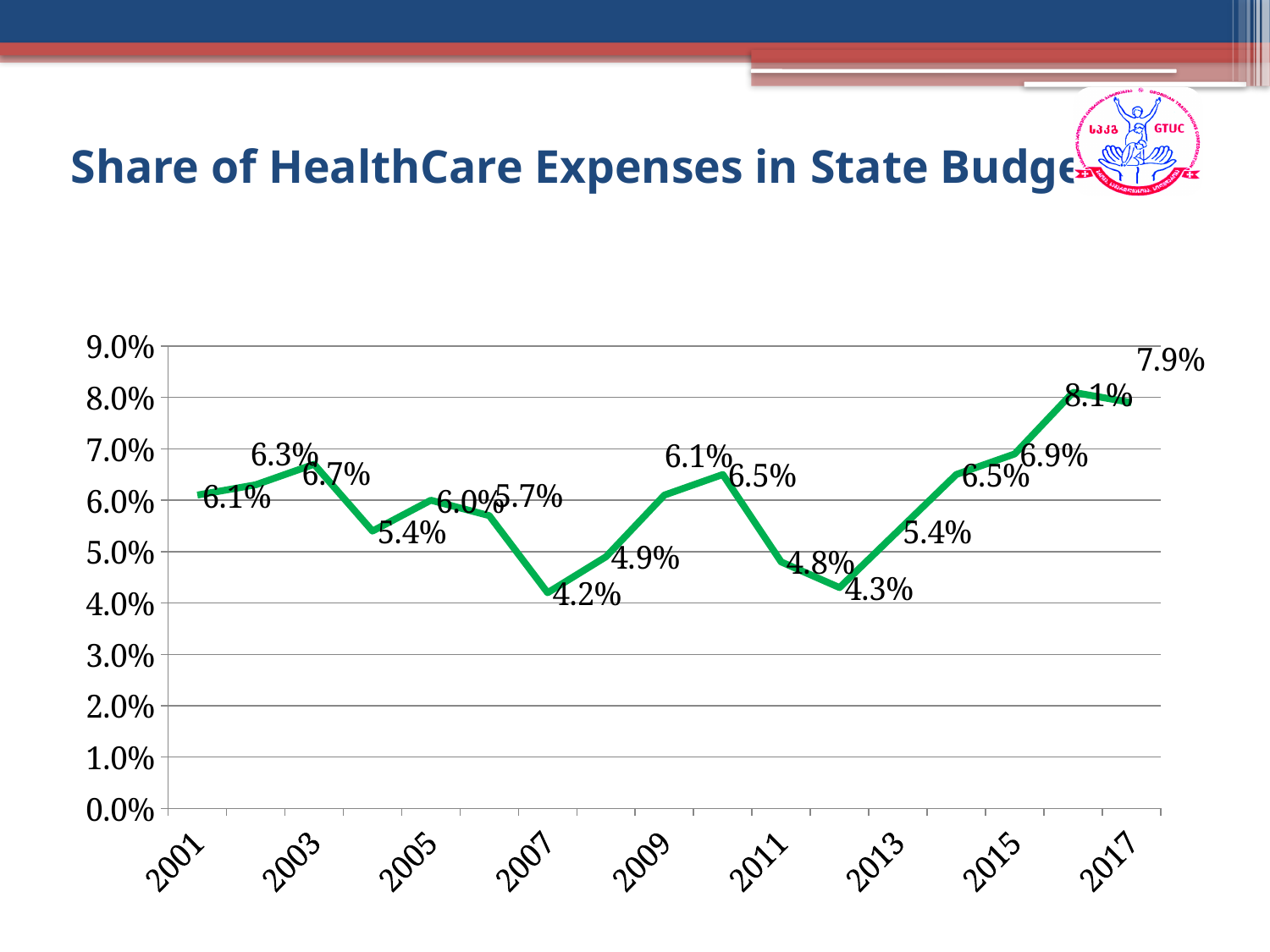
What is the share of healthcare expenses in the state budget in 2017? 7.9% By how many percentage points does the share in 2017 differ from the share in 2016? 0.2 percentage points What is the share of healthcare expenses in the state budget in 2003? 6.7% What type of chart is shown on the slide? line chart Does the share of healthcare expenses rise or fall from 2013 to 2016? rise In which year is the share of healthcare expenses lowest? 2007 What is the title of the chart? Share of HealthCare Expenses in State Budget How many years are plotted on the chart? 17 What is the share of healthcare expenses in the state budget in 2007? 4.2% Which year has a higher share of healthcare expenses, 2003 or 2013? 2003 What is the share of healthcare expenses in the state budget in 2001? 6.1% In which year is the share of healthcare expenses highest? 2016